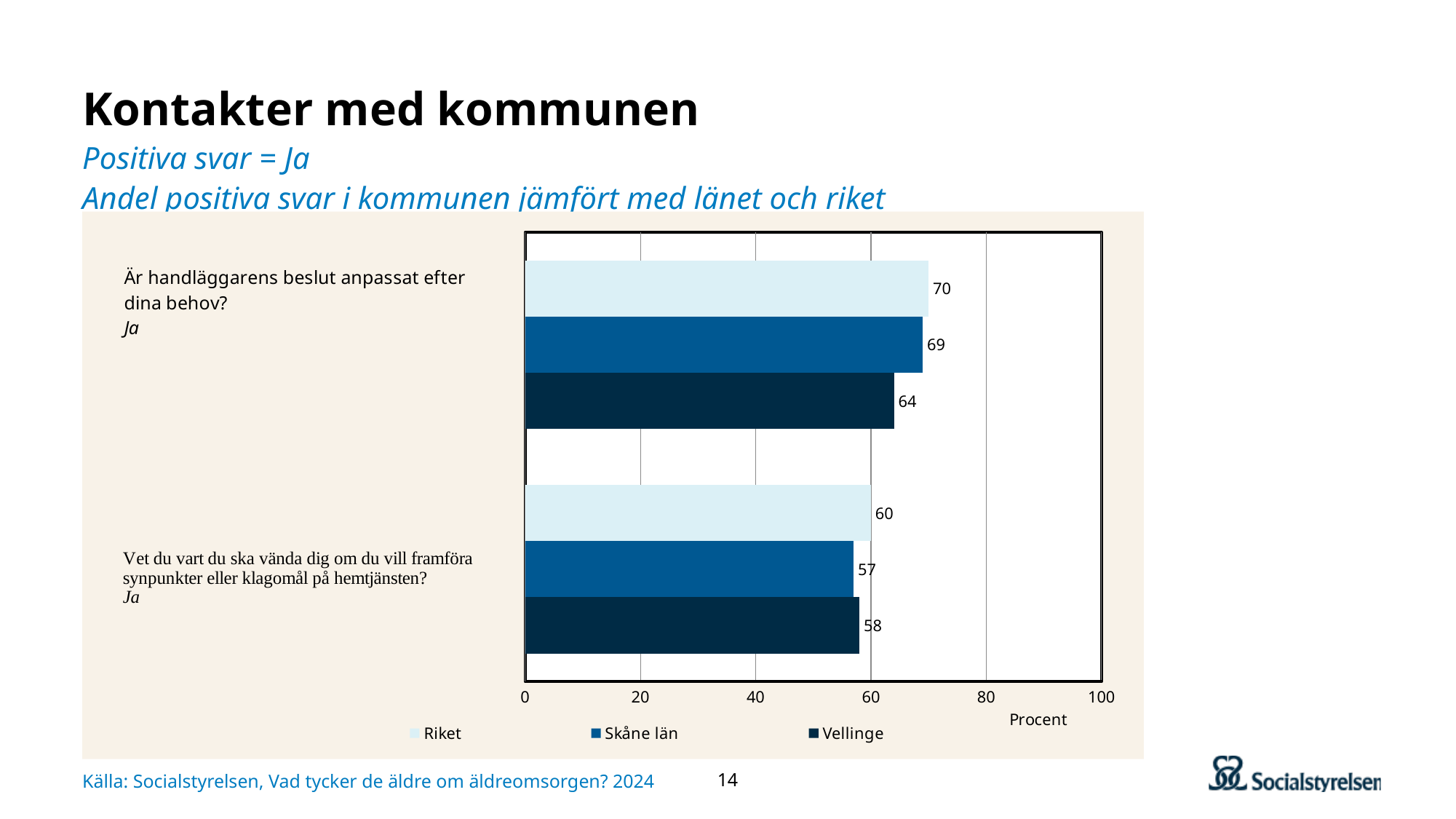
How many series does the legend list? 3 What is the difference between the Riket and Vellinge values on the question "Är handläggarens beslut anpassat efter dina behov?"? 6 What unit is shown on the x axis of the chart? Procent What kind of chart is shown on the slide? Bar chart What is the value for Riket on the question "Är handläggarens beslut anpassat efter dina behov?"? 70 Which series has the lowest value on the question "Vet du vart du ska vända dig om du vill framföra synpunkter eller klagomål på hemtjänsten?"? Skåne län Is the value for Skåne län on "Vet du vart du ska vända dig om du vill framföra synpunkter eller klagomål på hemtjänsten?" greater or less than 60? less Which is larger: the Vellinge value for "Är handläggarens beslut anpassat efter dina behov?" or the Vellinge value for "Vet du vart du ska vända dig om du vill framföra synpunkter eller klagomål på hemtjänsten?"? Är handläggarens beslut anpassat efter dina behov? What is the value for Vellinge on the question "Vet du vart du ska vända dig om du vill framföra synpunkter eller klagomål på hemtjänsten?"? 58 How many questions (categories) are shown in the chart? 2 Which series has the highest value on the question "Är handläggarens beslut anpassat efter dina behov?"? Riket What is the value for Skåne län on the question "Är handläggarens beslut anpassat efter dina behov?"? 69